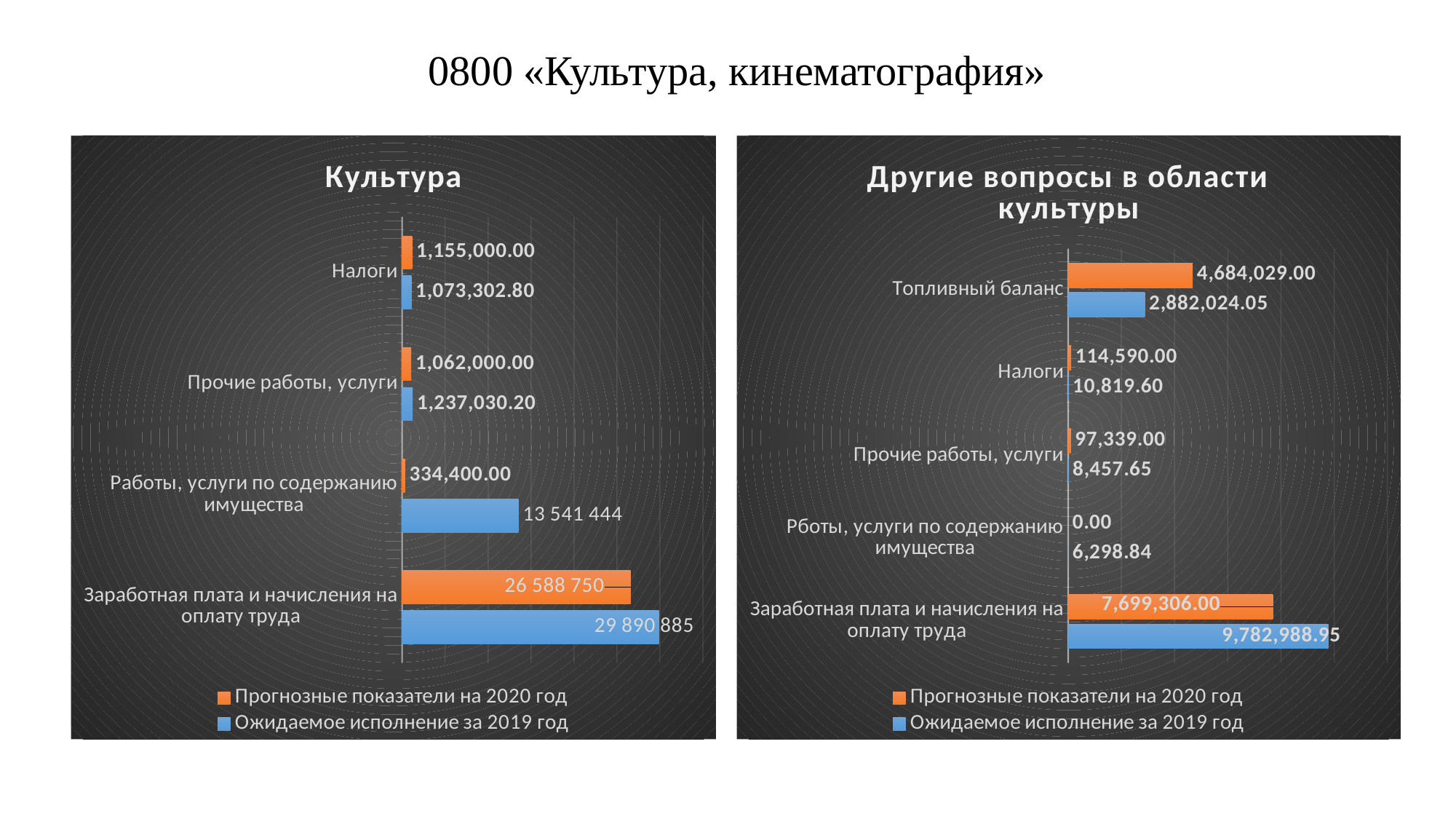
In the chart titled «Другие вопросы в области культуры», what is the value of «Прогнозные показатели на 2020 год» for «Топливный баланс»? 4,684,029.00 In the chart titled «Другие вопросы в области культуры», how many series does the legend list? 2 In the chart titled «Другие вопросы в области культуры», what is the value of «Ожидаемое исполнение за 2019 год» for «Прочие работы, услуги»? 8,457.65 In the chart titled «Культура», what is the value of «Ожидаемое исполнение за 2019 год» for «Работы, услуги по содержанию имущества»? 13 541 444 In the chart titled «Другие вопросы в области культуры», what is the difference between the 2020 forecast and the expected 2019 execution for «Топливный баланс»? 1,802,004.95 In the chart titled «Другие вопросы в области культуры», which is larger for «Заработная плата и начисления на оплату труда»: the 2020 forecast or the expected 2019 execution? Ожидаемое исполнение за 2019 год What type of chart is the chart titled «Другие вопросы в области культуры»? Bar chart In the chart titled «Культура», how many categories are shown? 4 In the chart titled «Культура», which category has the lowest value for «Прогнозные показатели на 2020 год»? Работы, услуги по содержанию имущества In the chart titled «Культура», what is the value of «Прогнозные показатели на 2020 год» for «Налоги»? 1,155,000.00 In the chart titled «Культура», which category has the highest value for «Ожидаемое исполнение за 2019 год»? Заработная плата и начисления на оплату труда In the chart titled «Культура», what is the difference between the 2020 forecast and the expected 2019 execution for «Налоги»? 81,697.20